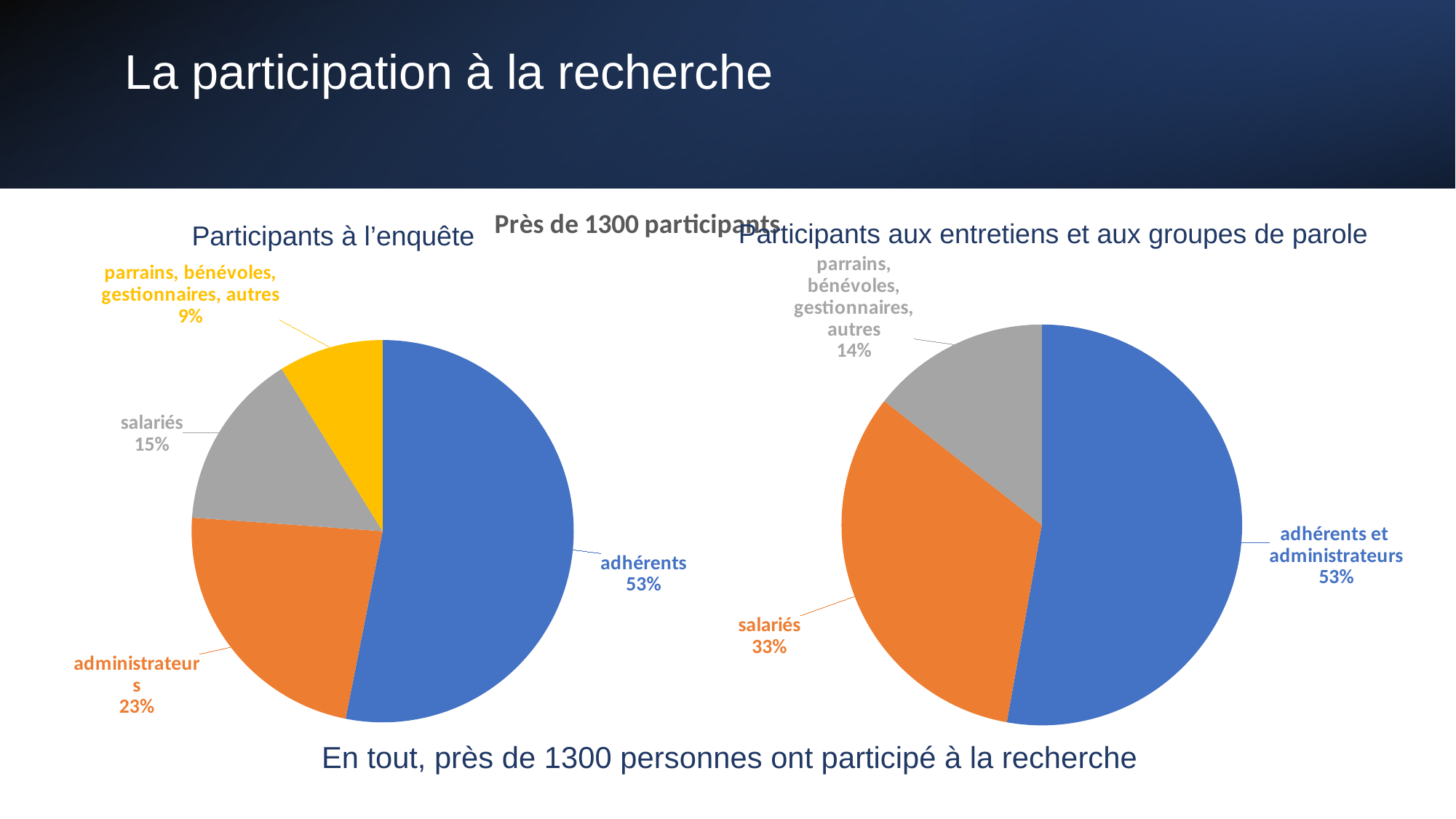
In the 'Participants à l'enquête' pie chart, what share do adhérents represent? 53% In the 'Participants aux entretiens et aux groupes de parole' pie chart, how many slices are there? 3 In the 'Participants à l'enquête' pie chart, what is the difference in percentage points between adhérents and administrateurs? 30 In the 'Participants à l'enquête' pie chart, what share do salariés represent? 15% In the 'Participants aux entretiens et aux groupes de parole' pie chart, which is larger: salariés or parrains, bénévoles, gestionnaires, autres? salariés In the 'Participants aux entretiens et aux groupes de parole' pie chart, what share do parrains, bénévoles, gestionnaires, autres represent? 14% In the 'Participants à l'enquête' pie chart, which category has the smallest slice? parrains, bénévoles, gestionnaires, autres In the 'Participants à l'enquête' pie chart, how many slices are there? 4 What type of chart is the chart on the left of the slide? pie chart In the 'Participants aux entretiens et aux groupes de parole' pie chart, which category has the largest slice? adhérents et administrateurs